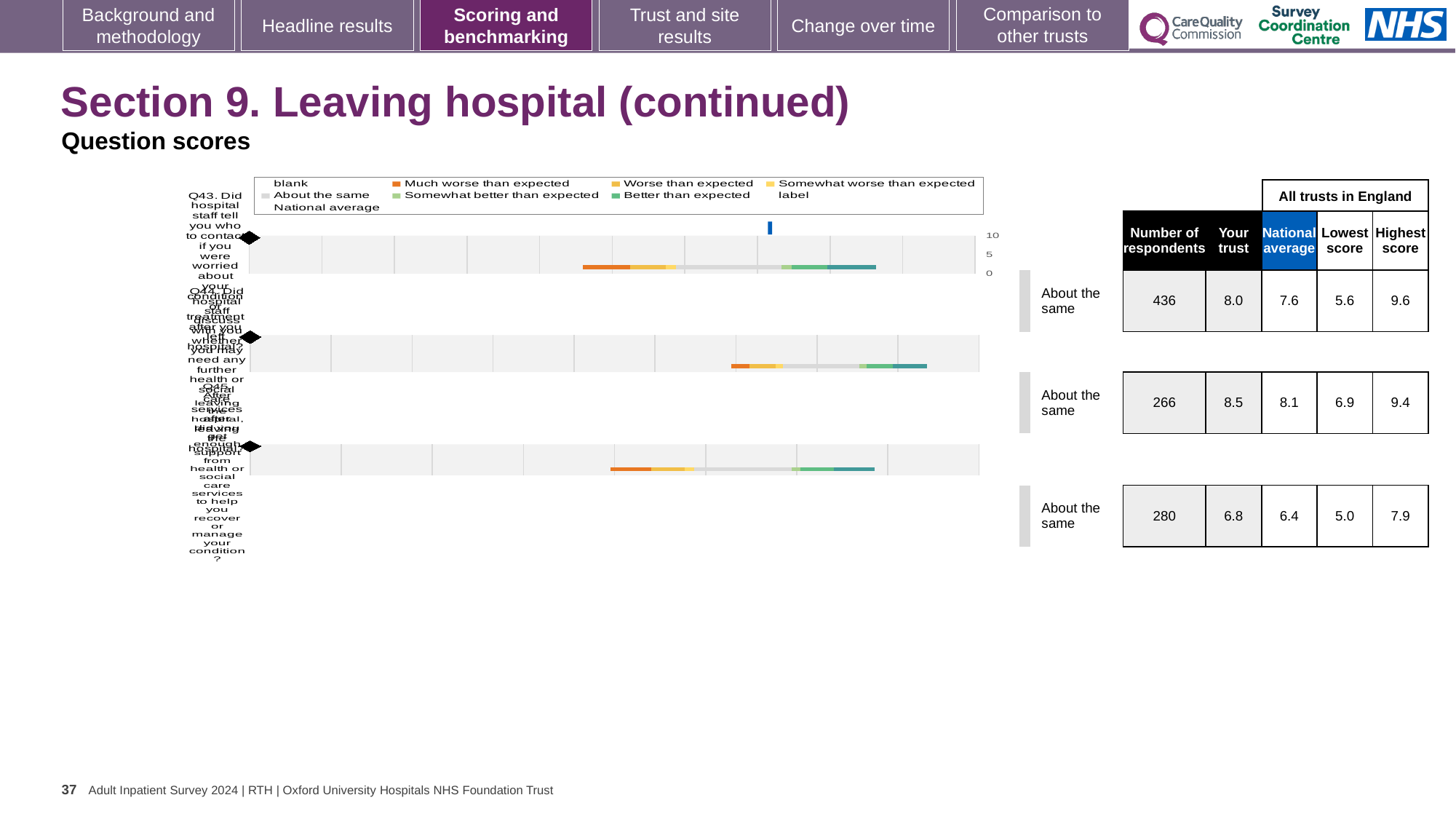
What is the highest value shown on the horizontal axis of the question score charts? 10 In the table next to the charts, what is the national average for the second question (Q44)? 8.1 In the table next to the charts, what is the 'Your trust' score for the first question (Q43)? 8.0 In the table next to the charts, which question has the lowest 'Your trust' score? Q45 (6.8) How many question score charts are shown on the slide? 3 What benchmark category is shown beside each of the three question score charts? About the same In the table next to the charts, what is the number of respondents for the third question (Q45)? 280 In the table next to the charts, what is the difference between the highest score and the lowest score for the first question (Q43)? 4.0 Which legend entry is shown in dark orange on the question score charts? Much worse than expected In the table next to the charts, is the 'Your trust' score for the second question (Q44) larger or smaller than its national average? larger What kind of chart is used to show the question scores on this slide? bar chart